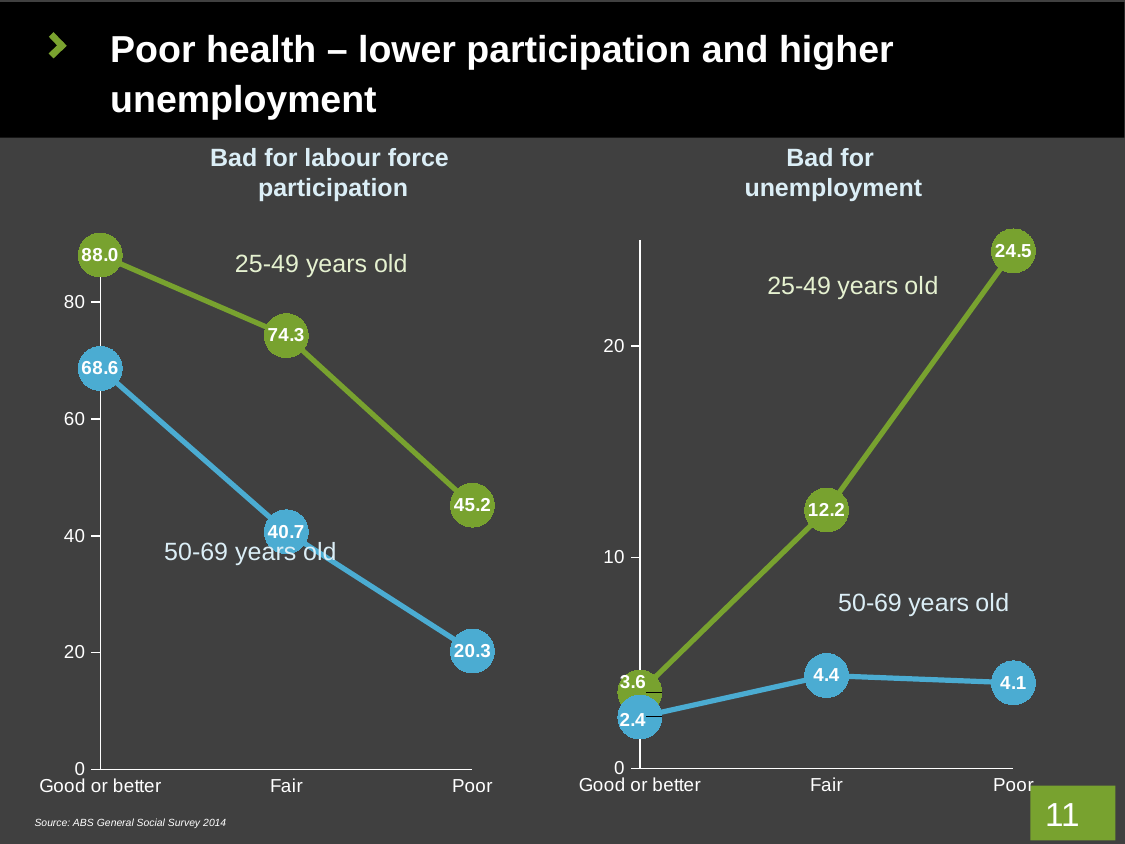
In the 'Bad for labour force participation' chart, what is the value for 50-69 years old at 'Poor' health? 20.3 In the 'Bad for unemployment' chart, which health category has the highest value for 25-49 years old? Poor In the 'Bad for labour force participation' chart, what is the difference between the 25-49 years old and 50-69 years old values at 'Good or better' health? 19.4 In the 'Bad for unemployment' chart, what is the difference between the 25-49 years old values at 'Poor' and 'Fair' health? 12.3 In the 'Bad for labour force participation' chart, which health category has the lowest value for 50-69 years old? Poor In the 'Bad for unemployment' chart, which is larger at 'Fair' health: the 25-49 years old value or the 50-69 years old value? 25-49 years old How many health categories are shown on the x axis of the 'Bad for unemployment' chart? 3 In the 'Bad for unemployment' chart, what is the value for 25-49 years old at 'Poor' health? 24.5 In the 'Bad for unemployment' chart, what is the value for 50-69 years old at 'Good or better' health? 2.4 In the 'Bad for labour force participation' chart, what is the value for 25-49 years old at 'Fair' health? 74.3 What kind of chart is the 'Bad for labour force participation' chart? line chart In the 'Bad for labour force participation' chart, do the values for 25-49 years old rise or fall from 'Good or better' to 'Poor'? fall